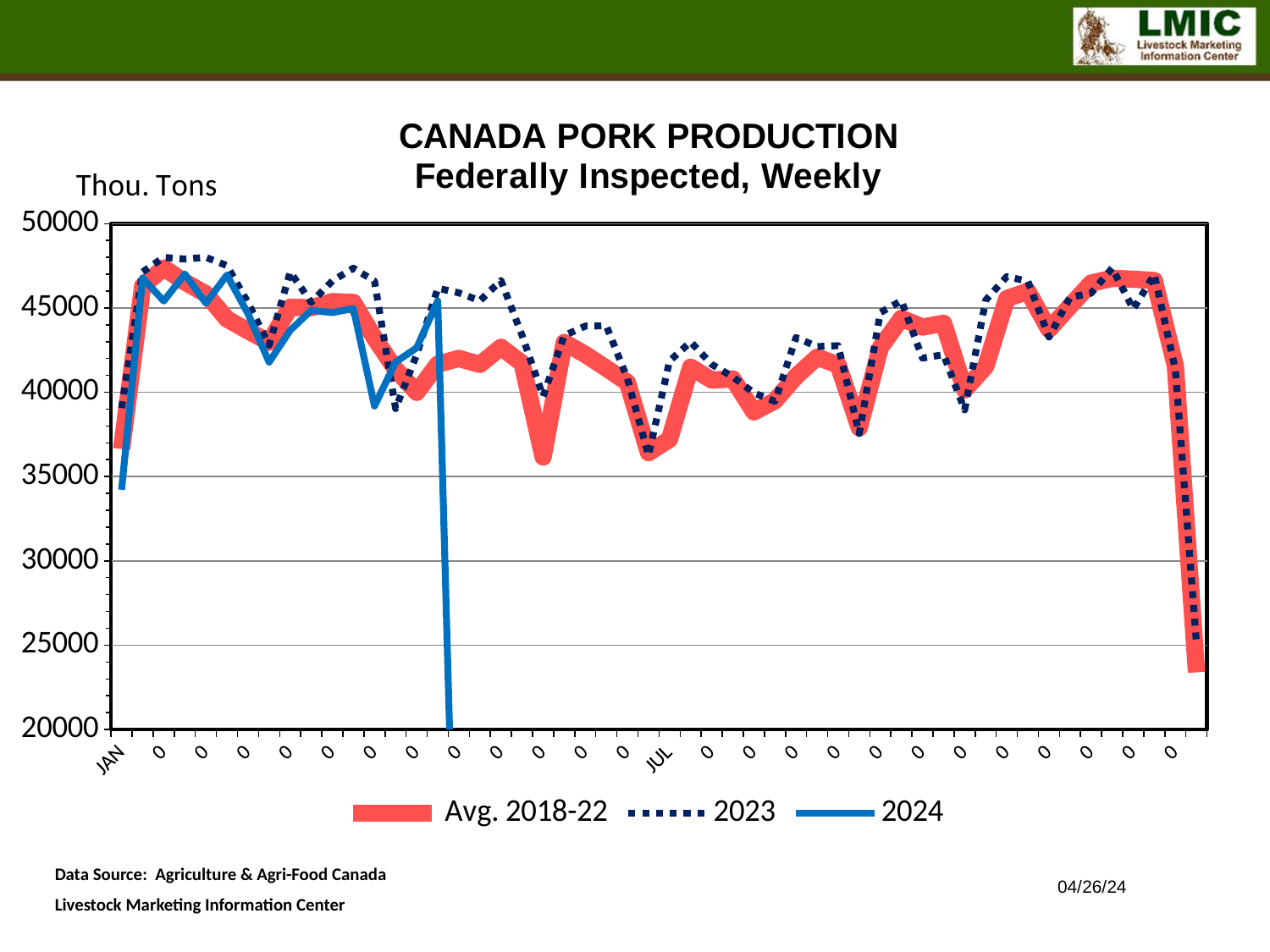
Is the 2023 value in the final week of the year greater or less than 30000? less What unit is shown on the vertical axis label? Thou. Tons Is the Avg. 2018-22 value in the final week of the year greater or less than 25000? less Is the 2024 value in the first week of January greater or less than 35000? less What kind of chart is shown on the slide? line chart How many series does the legend list? 3 Does the Avg. 2018-22 series rise or fall over the last few weeks of the year? fall In the first week of January, which is higher, the 2024 value or the Avg. 2018-22 value? Avg. 2018-22 Which series is drawn as a dotted line? 2023